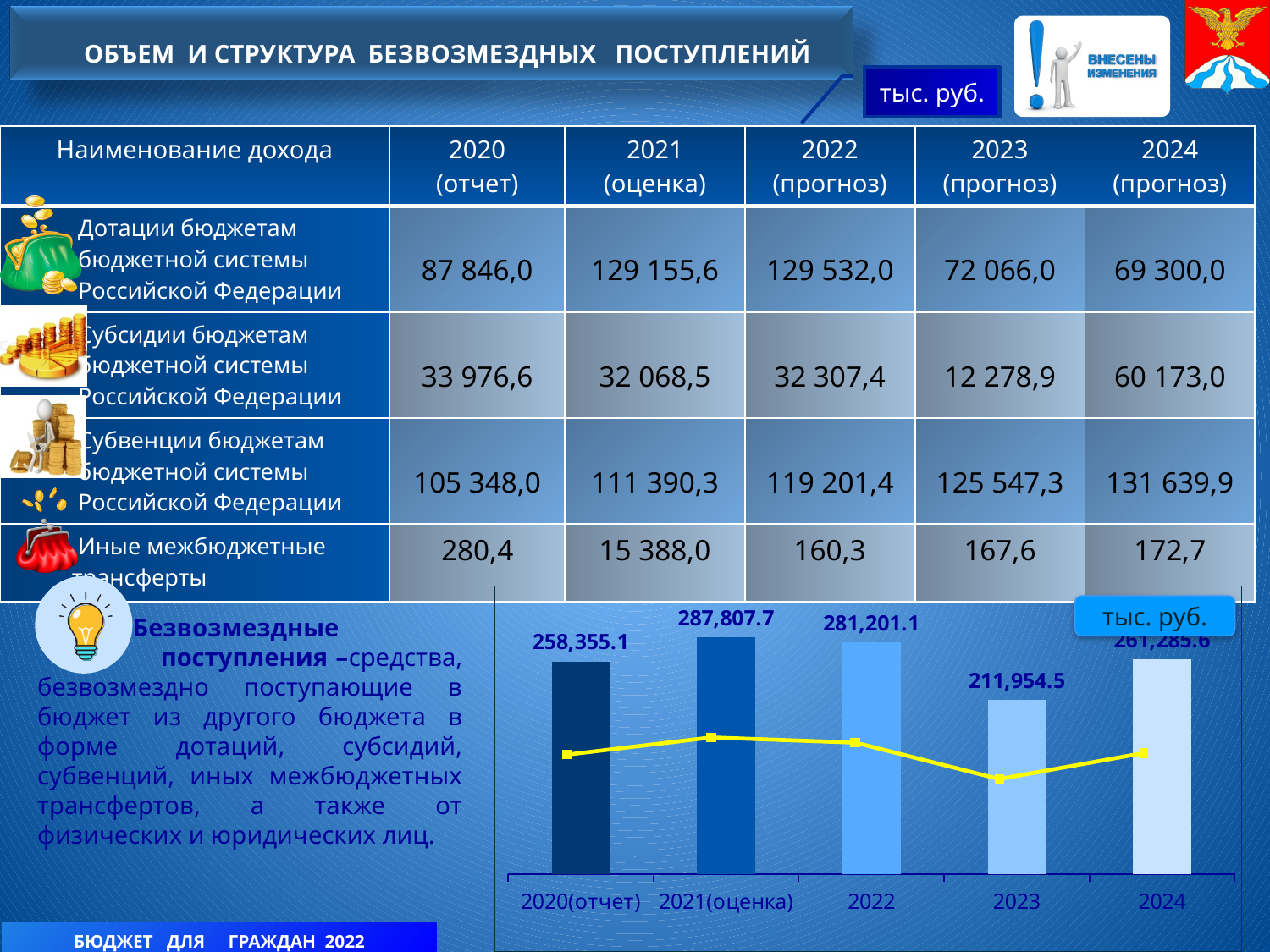
What is the difference between the bar values for 2022 and 2023? 69,246.6 What is the difference between the bar values for 2021(оценка) and 2020(отчет)? 29,452.6 What is the value of the bar for 2022 in the chart? 281,201.1 Do the bar values rise or fall from 2021(оценка) to 2023? fall What is the value of the bar for 2021(оценка) in the chart? 287,807.7 Which year has the highest bar in the chart? 2021(оценка) What is the value of the bar for 2020(отчет) in the chart? 258,355.1 What is the value of the bar for 2023 in the chart? 211,954.5 Which bar is larger, 2020(отчет) or 2023? 2020(отчет) Which year has the lowest bar in the chart? 2023 How many bars are shown in the chart? 5 What kind of chart is shown at the bottom right of the slide? bar chart